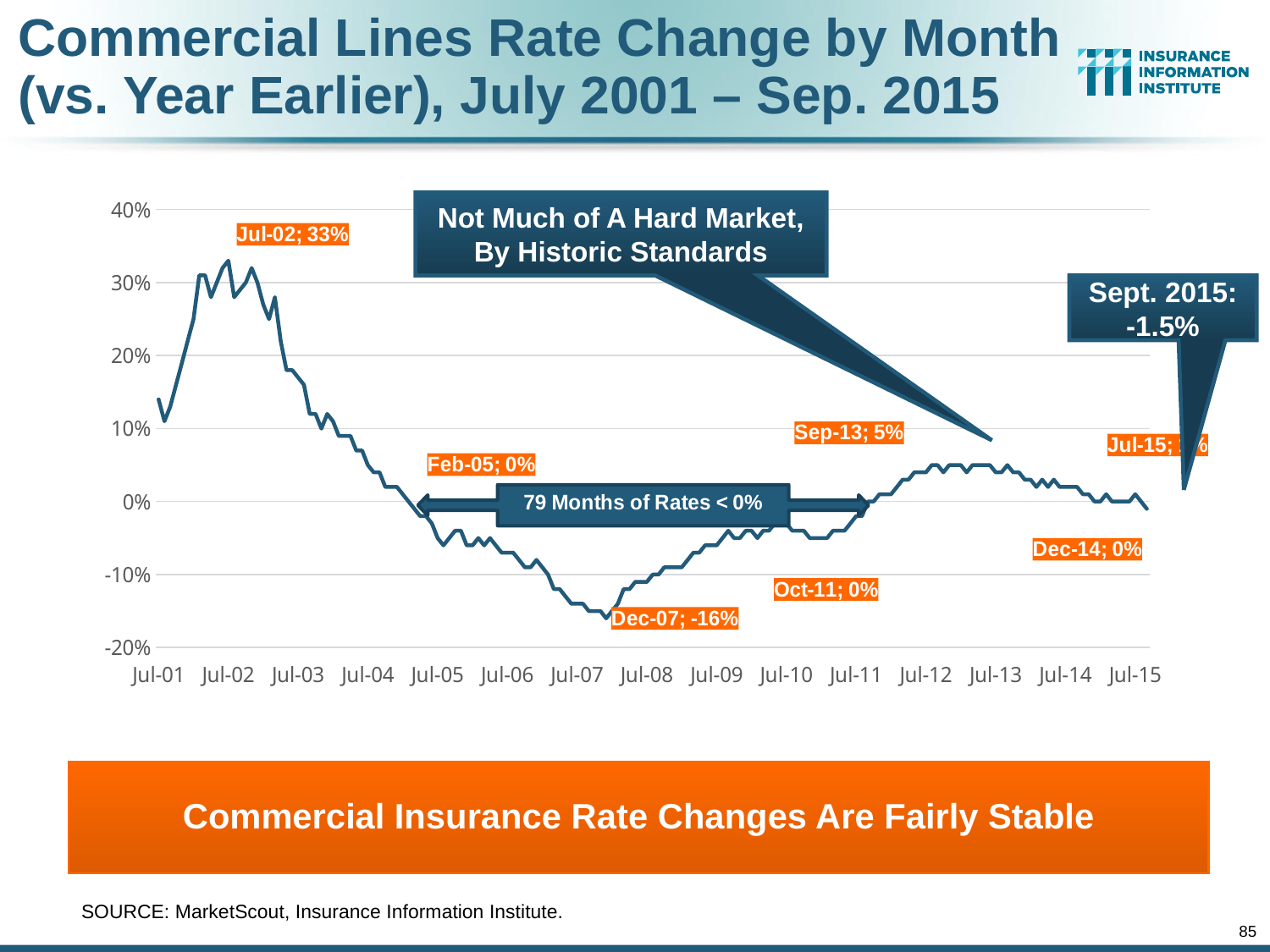
What kind of chart is shown on the slide? line chart Which labeled month has the lowest rate change? Dec-07 What was the commercial lines rate change in Sep-13? 5% Which labeled month has the highest rate change? Jul-02 What was the commercial lines rate change in Feb-05? 0% What is the difference in percentage points between the Jul-02 value and the Dec-07 value? 49 percentage points What was the commercial lines rate change in Dec-07? -16% Is the value for Jul-08 greater or less than 0%? less Does the rate change rise or fall between Jul-02 and Dec-07? fall Which is larger, the rate change in Jul-02 or in Sep-13? Jul-02 What was the commercial lines rate change in Jul-02? 33% What rate change does the callout give for Sept. 2015? -1.5%